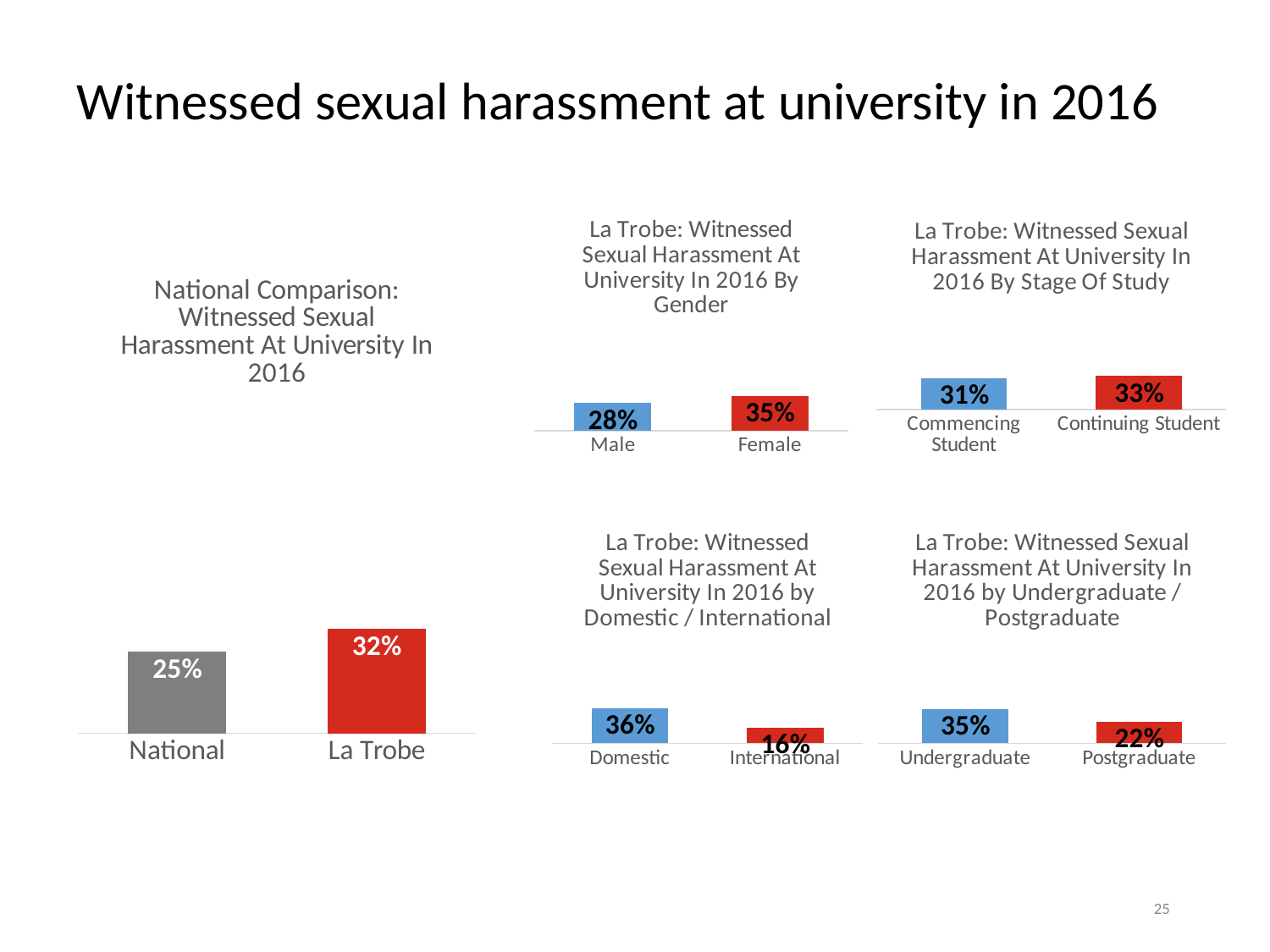
In the Undergraduate / Postgraduate chart, what is the difference between Undergraduate and Postgraduate? 13% In the National Comparison chart, what is the value for National? 25% In the By Stage Of Study chart, what is the difference between Continuing Student and Commencing Student? 2% In the By Stage Of Study chart, what is the value for Commencing Student? 31% In the By Gender chart, what is the value for Female? 35% In the National Comparison chart, what is the value for La Trobe? 32% In the Undergraduate / Postgraduate chart, what is the value for Postgraduate? 22% In the By Gender chart, which category is higher, Male or Female? Female In the Domestic / International chart, which category has the lowest value? International In the National Comparison chart, what is the difference between the La Trobe and National values? 7% What type of chart is the National Comparison chart? Bar chart In the Domestic / International chart, what is the value for Domestic? 36%